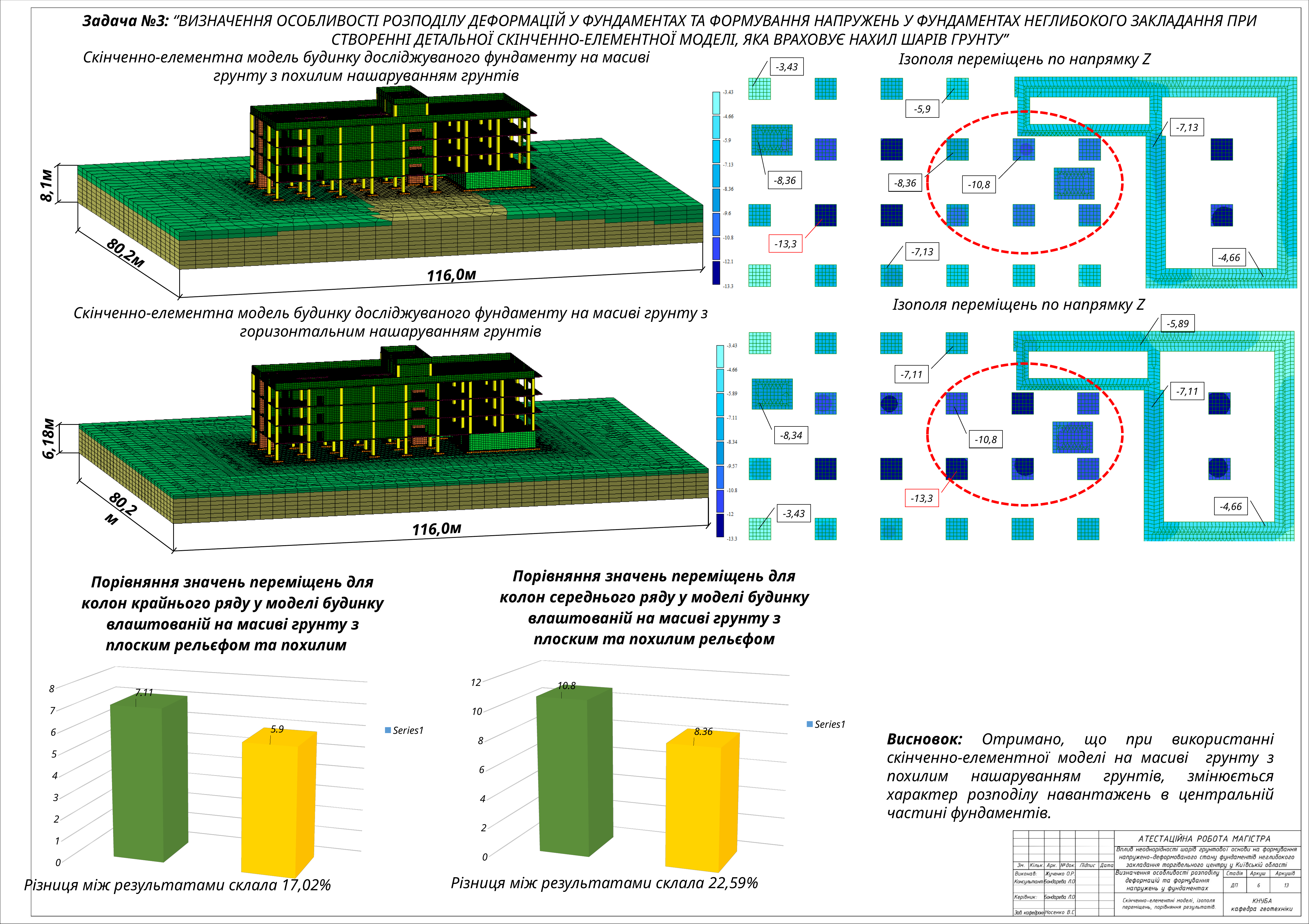
On the left bar chart (колон крайнього ряду), what value is labelled on the yellow bar? 5.9 On the left bar chart (колон крайнього ряду), what value is labelled on the green bar? 7.11 On the left bar chart, which bar has the lowest value? the yellow bar On the right bar chart, what is the difference between the green bar and the yellow bar? 2.44 How many bars are plotted on the left bar chart? 2 On the right bar chart, which bar is taller, the green one or the yellow one? the green one What is the legend entry shown next to the left bar chart? Series1 What type of chart is used at the bottom left of the slide? bar chart How many series does the legend of the right bar chart list? 1 On the left bar chart, what is the difference between the green bar and the yellow bar? 1.21 On the right bar chart (колон середнього ряду), what value is labelled on the yellow bar? 8.36 On the right bar chart (колон середнього ряду), what value is labelled on the green bar? 10.8